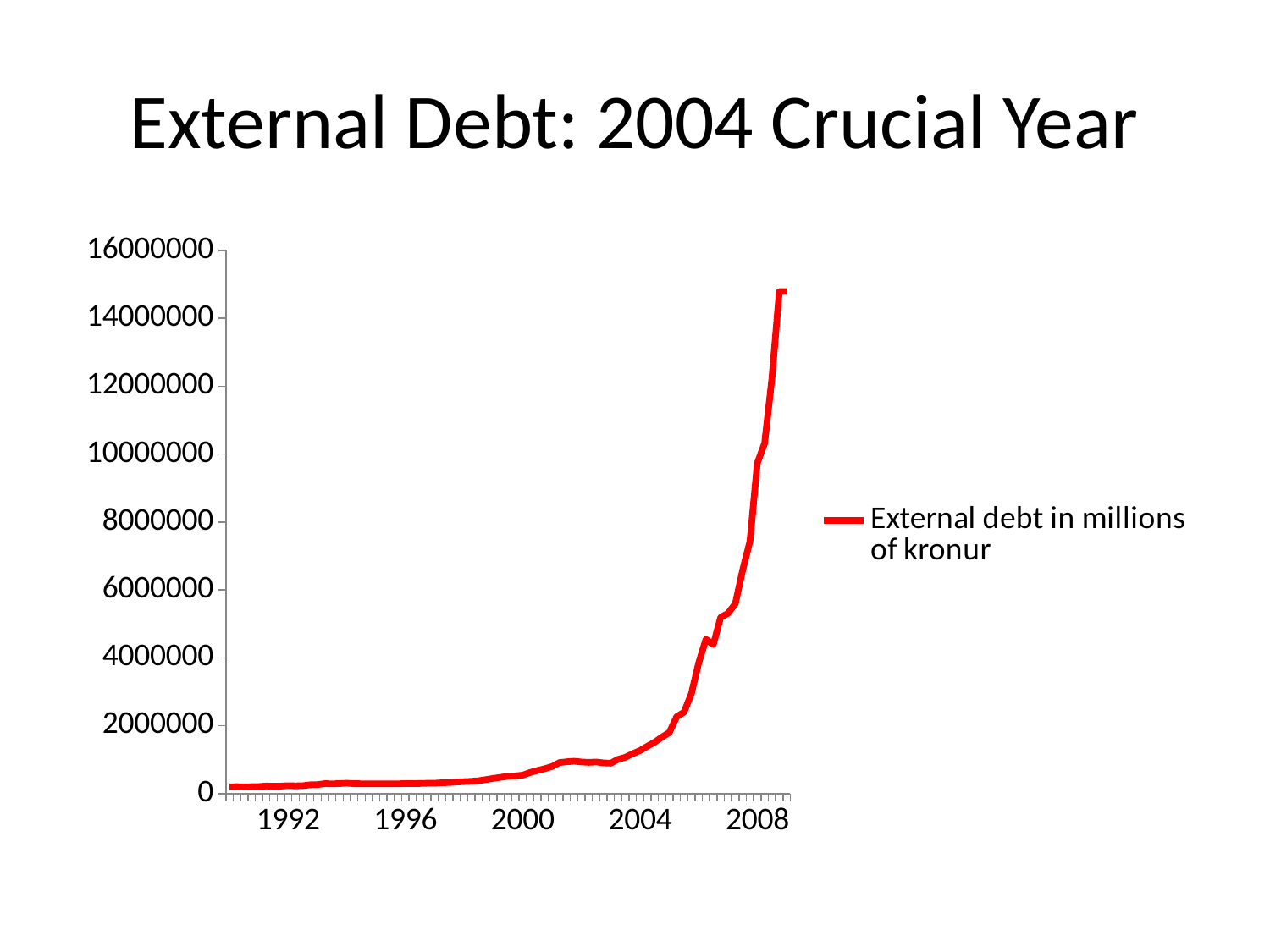
Which year has the larger external debt value, 2004 or 2008? 2008 Is the value for external debt in 2008 greater or less than 6000000? greater Is the value for external debt in 2004 greater or less than 2000000? less Which year has the larger external debt value, 1996 or 2006? 2006 What kind of chart is shown on the slide? line chart What is the title of the slide containing the chart? External Debt: 2004 Crucial Year How many series does the legend list? 1 Is the highest value reached by the external debt line greater or less than 14000000? greater Do the values of external debt generally rise or fall from 1992 to 2008? rise What is the legend entry for the plotted series? External debt in millions of kronur